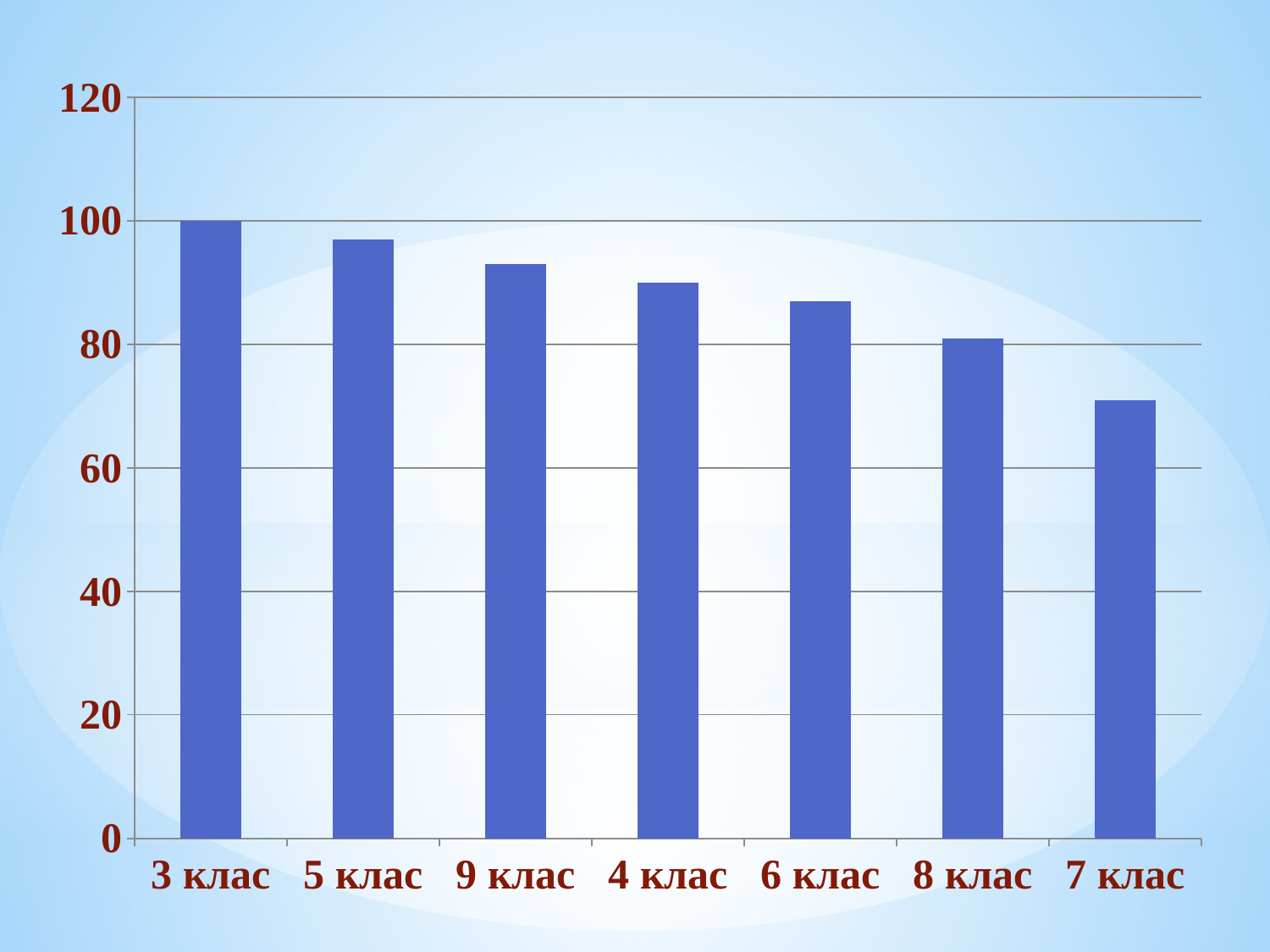
Which class has the lowest bar? 7 клас How many categories (classes) are shown on the x axis? 7 Is the value for 6 клас greater or less than 60? greater Is the value for 5 клас greater or less than 80? greater What is the value for 3 клас? 100 Is the value for 7 клас greater or less than 80? less What kind of chart is shown on the slide? bar chart What is the highest tick value shown on the vertical axis? 120 Do the bar values rise or fall from left to right along the x axis? fall Which class has the highest bar? 3 клас Which is larger, the value for 9 клас or the value for 8 клас? 9 клас